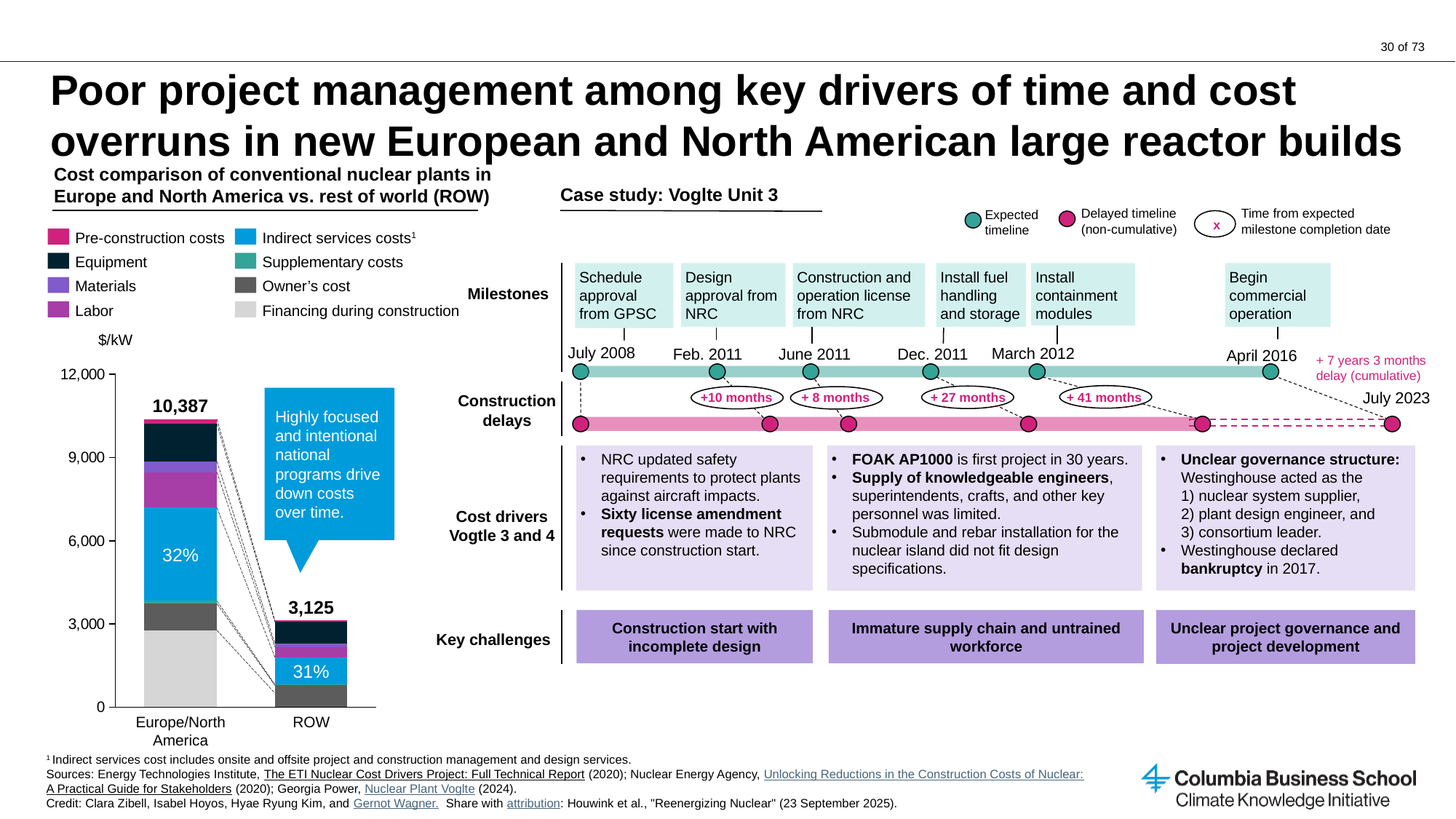
In the cost comparison chart, what percentage label is shown on the indirect services costs segment of the Europe/North America bar? 32% In the cost comparison chart, is the total for ROW greater or less than 6,000? less In the cost comparison chart, which category has the lowest total cost? ROW In the cost comparison chart, what is the total cost in $/kW for ROW? 3,125 In the cost comparison chart, which bar has the higher total, Europe/North America or ROW? Europe/North America In the cost comparison chart, what is the total cost in $/kW for Europe/North America? 10,387 In the cost comparison chart, what is the difference between the Europe/North America total and the ROW total? 7,262 How many cost components does the legend of the cost comparison chart list? 8 What unit is shown on the y axis of the cost comparison chart? $/kW In the cost comparison chart, what percentage label is shown on the indirect services costs segment of the ROW bar? 31% How many categories (bars) are shown in the cost comparison chart? 2 What type of chart is the cost comparison of conventional nuclear plants? Stacked bar chart